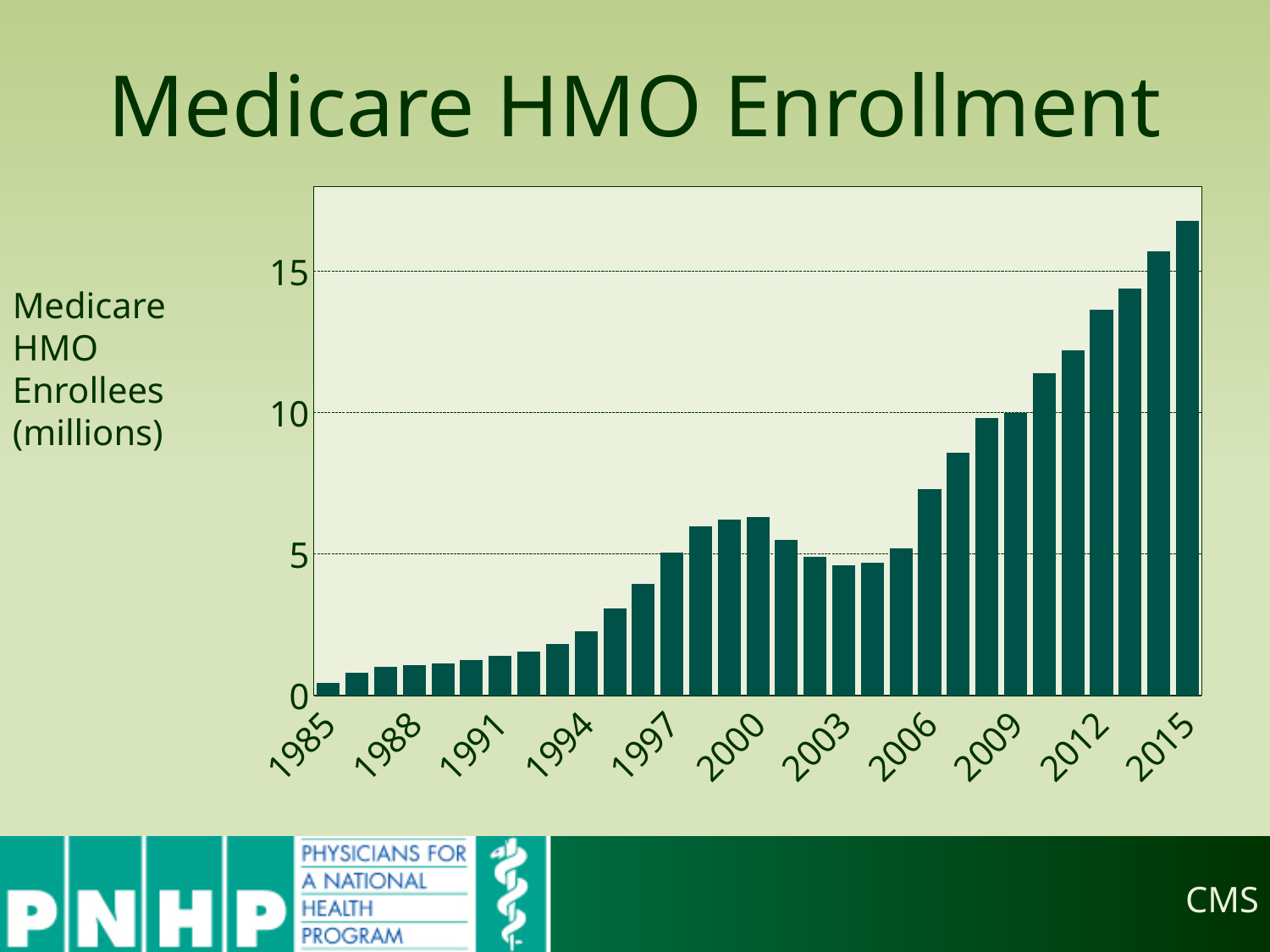
What kind of chart is shown on the slide? bar chart Which year has the lowest Medicare HMO enrollment? 1985 Which year has the larger enrollment, 2000 or 2003? 2000 Is the value for 2012 greater or less than 10? greater What is the title of the chart? Medicare HMO Enrollment Overall, do the values rise or fall from 1985 to 2015? rise What does the vertical axis of the chart measure, according to the label on the slide? Medicare HMO Enrollees (millions) Is the value for 2015 greater or less than 15? greater Is the value for 2003 greater or less than 5? less Which year has the highest Medicare HMO enrollment? 2015 Which year has the larger enrollment, 2009 or 2012? 2012